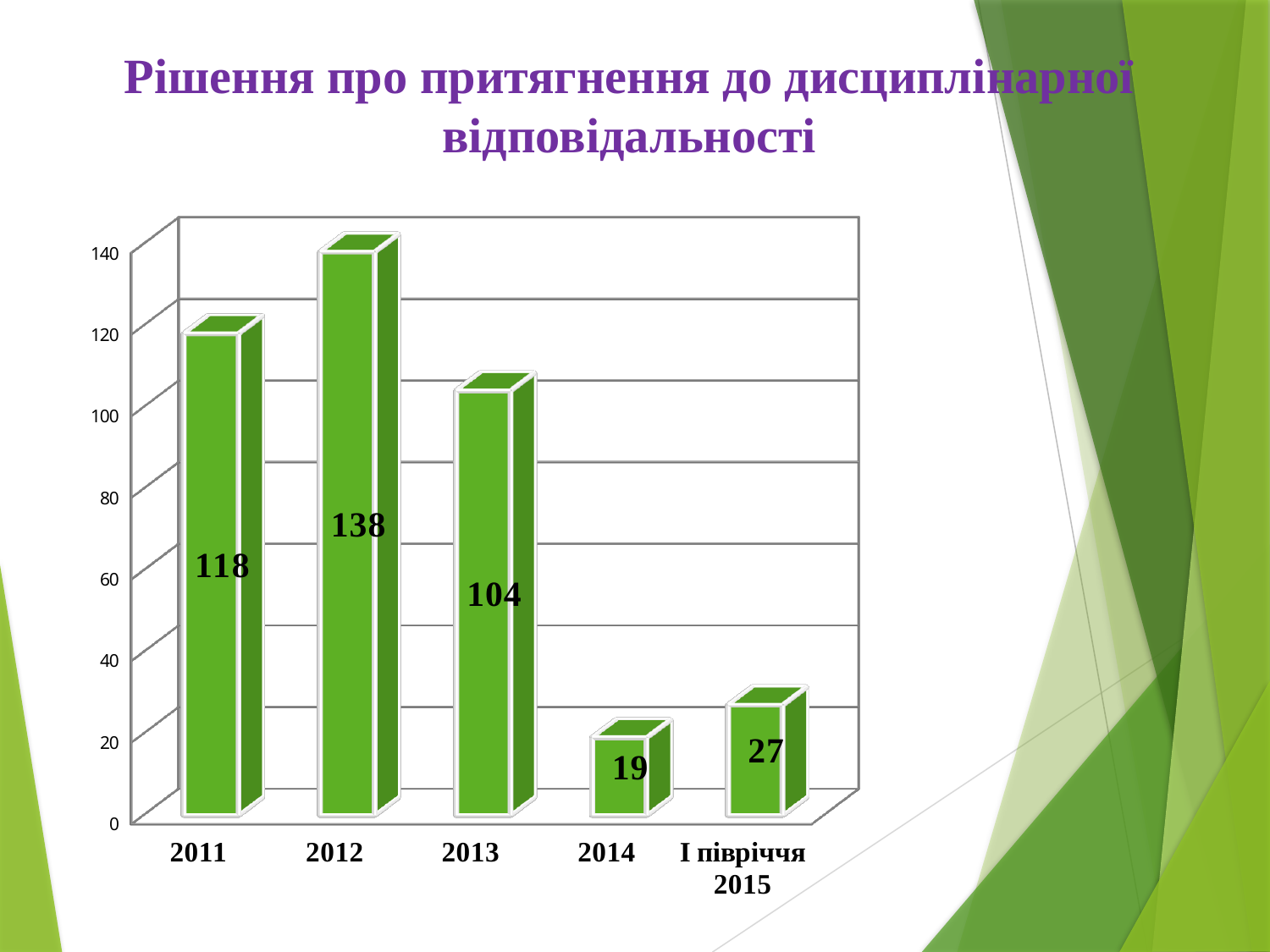
What is the value for І півріччя 2015? 27 What is the title of the chart on the slide? Рішення про притягнення до дисциплінарної відповідальності Which category has the highest value? 2012 What is the value for 2012? 138 What is the difference between the values for 2012 and 2013? 34 What kind of chart is shown on the slide? bar chart What is the value for 2011? 118 What is the value for 2014? 19 How many categories are shown on the x axis? 5 What is the value for 2013? 104 Which category has the lowest value? 2014 Which is larger, the value for 2011 or the value for 2013? 2011